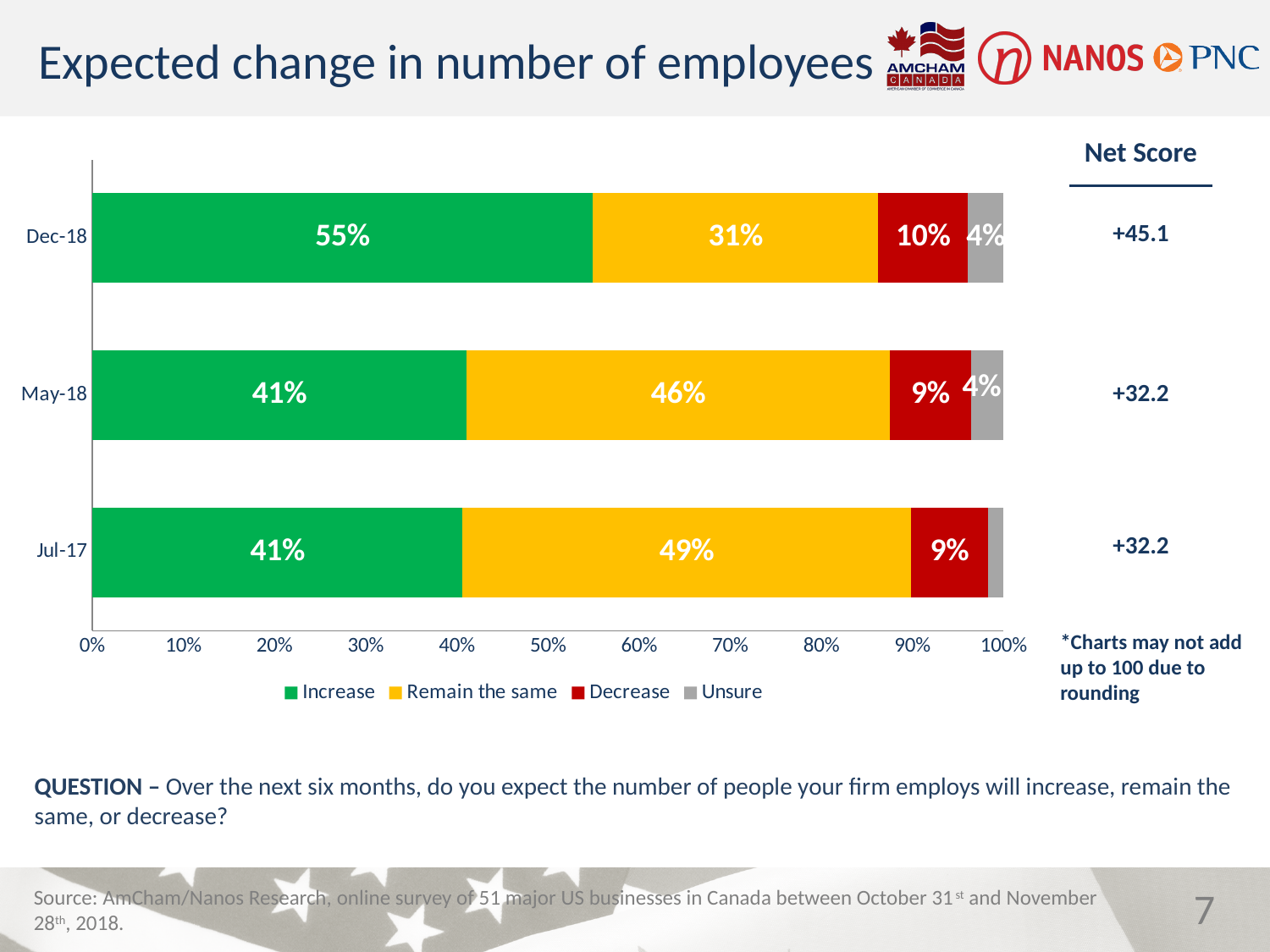
What is the 'Remain the same' value for May-18? 46% Which is larger: the 'Remain the same' value for Jul-17 or for May-18? Jul-17 What is the difference between the 'Increase' values for Dec-18 and May-18? 14% Which period has the highest 'Increase' value? Dec-18 How many series does the legend list? 4 What percentage of respondents expected an increase in Dec-18? 55% What is the Net Score shown for Dec-18? +45.1 How many periods (categories) are shown on the chart? 3 What is the 'Unsure' value for Dec-18? 4% What is the 'Decrease' value for Jul-17? 9% Which period has the lowest 'Remain the same' value? Dec-18 What kind of chart is shown on the slide? Stacked bar chart